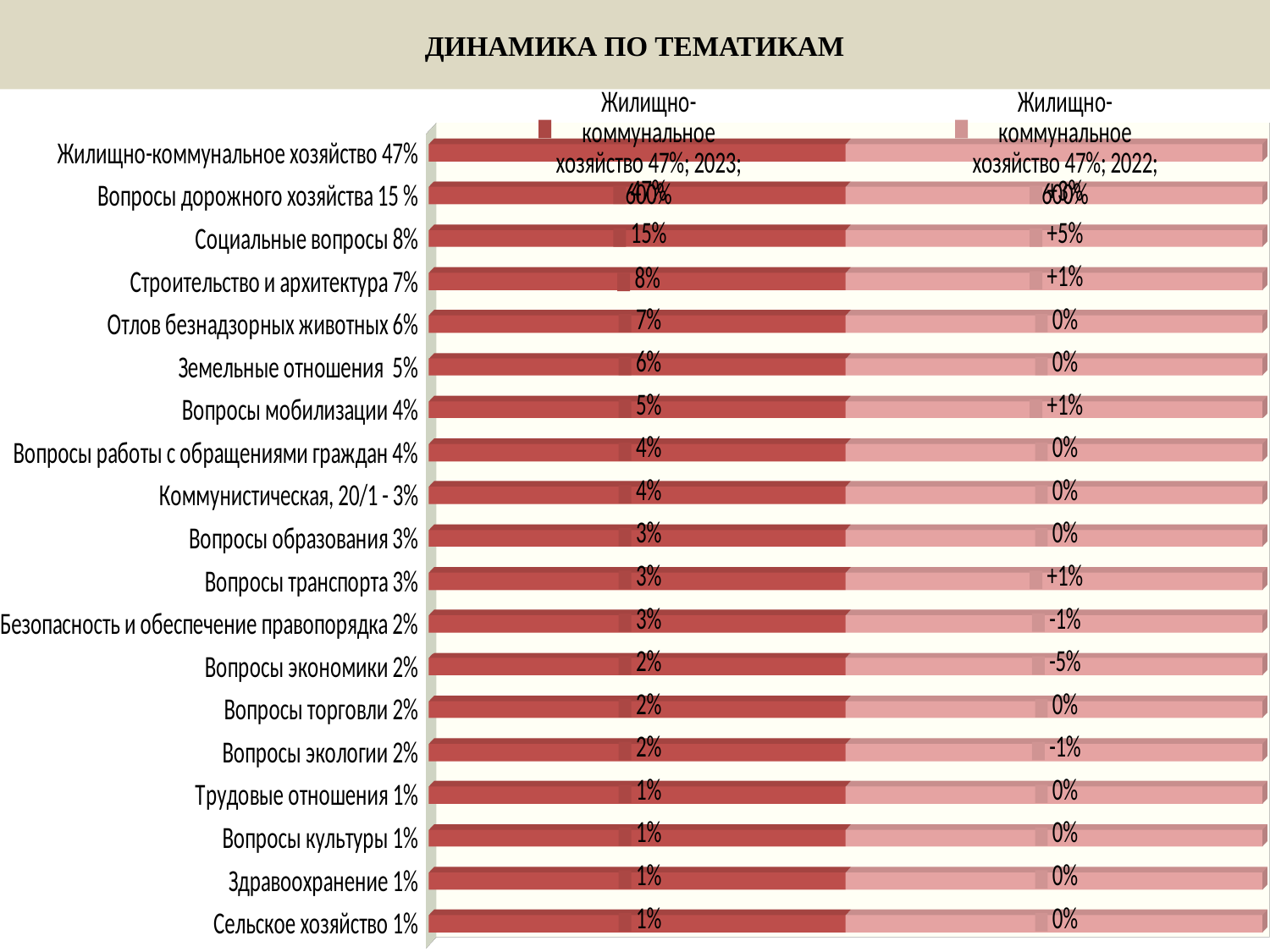
What is the difference in share between Жилищно-коммунальное хозяйство and Вопросы дорожного хозяйства? 32 percentage points What share is shown for Социальные вопросы? 8% What share is shown for Жилищно-коммунальное хозяйство? 47% Which topic has the highest share on the chart? Жилищно-коммунальное хозяйство How many categories (topics) are listed on the chart? 19 What share is shown for Отлов безнадзорных животных? 6% What share is shown for Вопросы дорожного хозяйства? 15 % Which two years are named in the chart's legend? 2023 and 2022 How many series does the chart's legend list? 2 What is the title of the chart on the slide? ДИНАМИКА ПО ТЕМАТИКАМ Which has the larger share: Вопросы дорожного хозяйства or Социальные вопросы? Вопросы дорожного хозяйства What kind of chart is shown on the slide? Bar chart